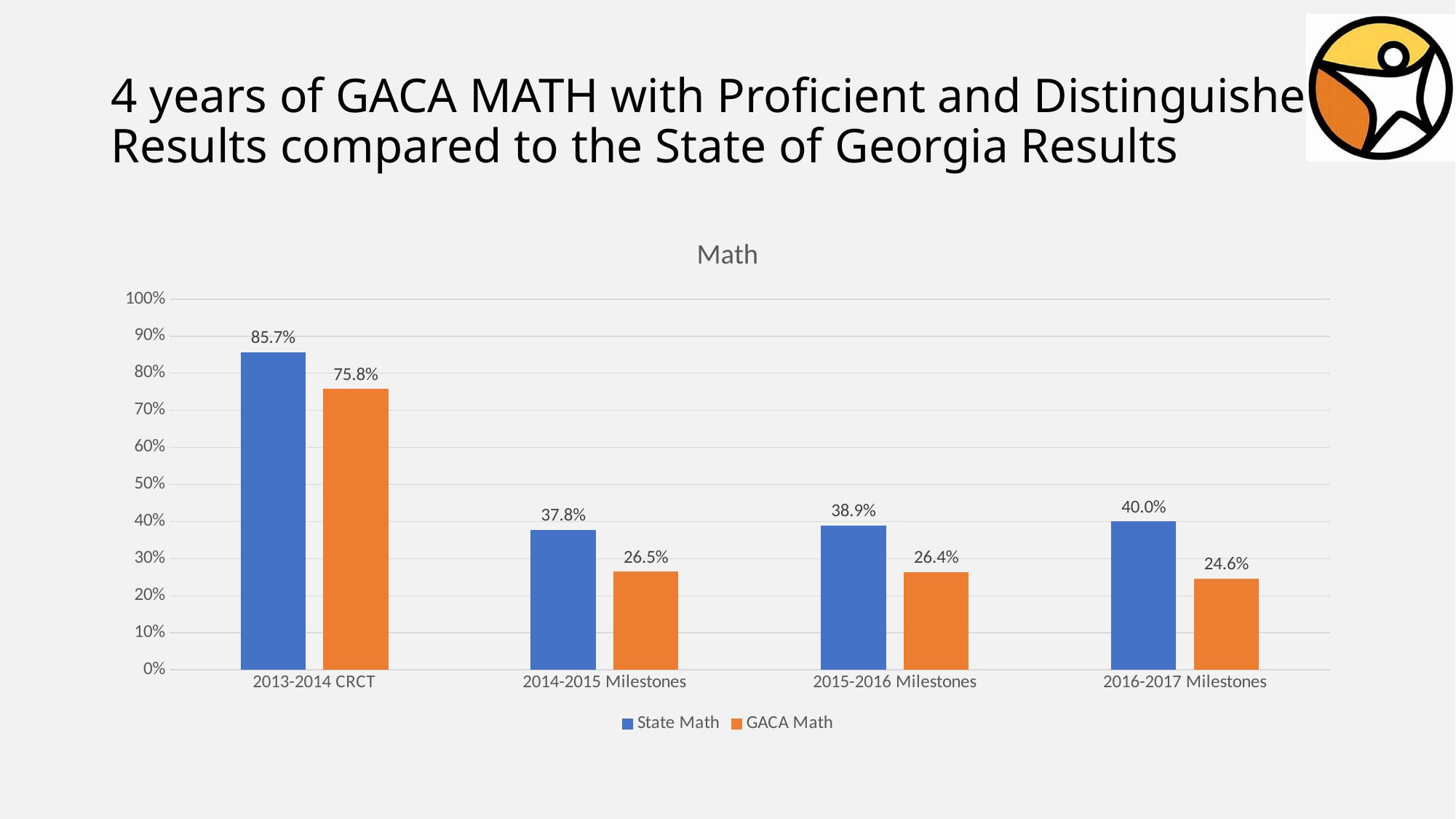
What is the difference between State Math and GACA Math for 2016-2017 Milestones? 15.4% What is the State Math value for 2013-2014 CRCT? 85.7% What kind of chart is shown? Bar chart Which is larger for 2015-2016 Milestones, State Math or GACA Math? State Math Which category has the highest State Math value? 2013-2014 CRCT What is the GACA Math value for 2014-2015 Milestones? 26.5% How many categories are shown on the x axis? 4 What is the title of the chart? Math Which category has the lowest GACA Math value? 2016-2017 Milestones How many series does the legend list? 2 What is the difference between State Math and GACA Math for 2013-2014 CRCT? 9.9% What is the GACA Math value for 2016-2017 Milestones? 24.6%